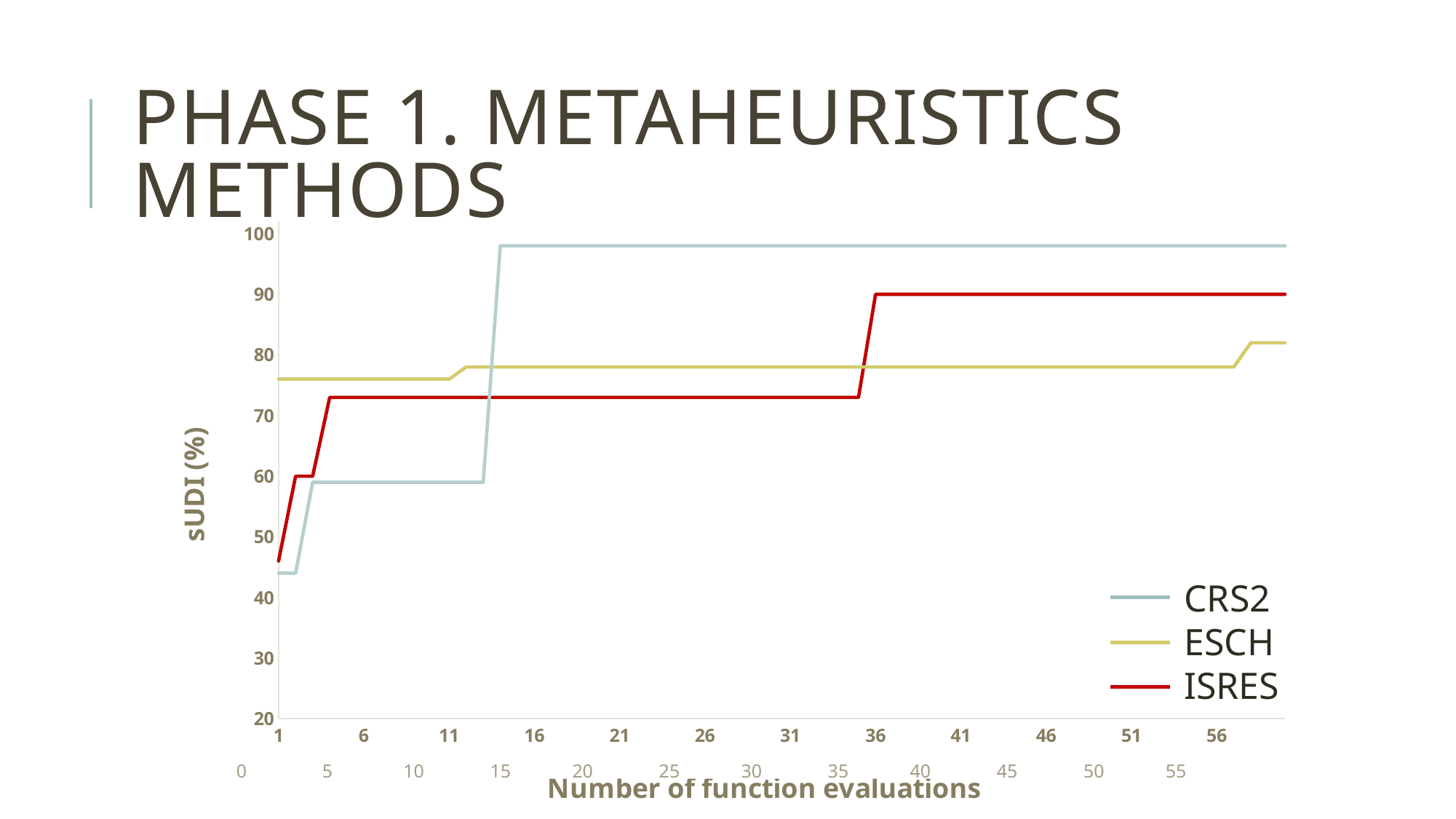
Which series reaches the highest sUDI value by the end of the x axis? CRS2 Which series are listed in the legend? CRS2, ESCH, ISRES Is the value for CRS2 at 30 function evaluations greater or less than 90? greater Is the value for ISRES at 20 function evaluations greater or less than 80? less What is the title of the x axis? Number of function evaluations At 6 function evaluations, which series has the higher sUDI value, ISRES or CRS2? ISRES What kind of chart is shown on the slide? Line chart At 30 function evaluations, which series has the higher sUDI value, CRS2 or ISRES? CRS2 Do the sUDI values for the series rise or fall as the number of function evaluations increases? Rise How many series does the legend list? 3 Is the value for ISRES at 50 function evaluations greater or less than 80? greater Which series has the lowest sUDI value at the end of the x axis? ESCH